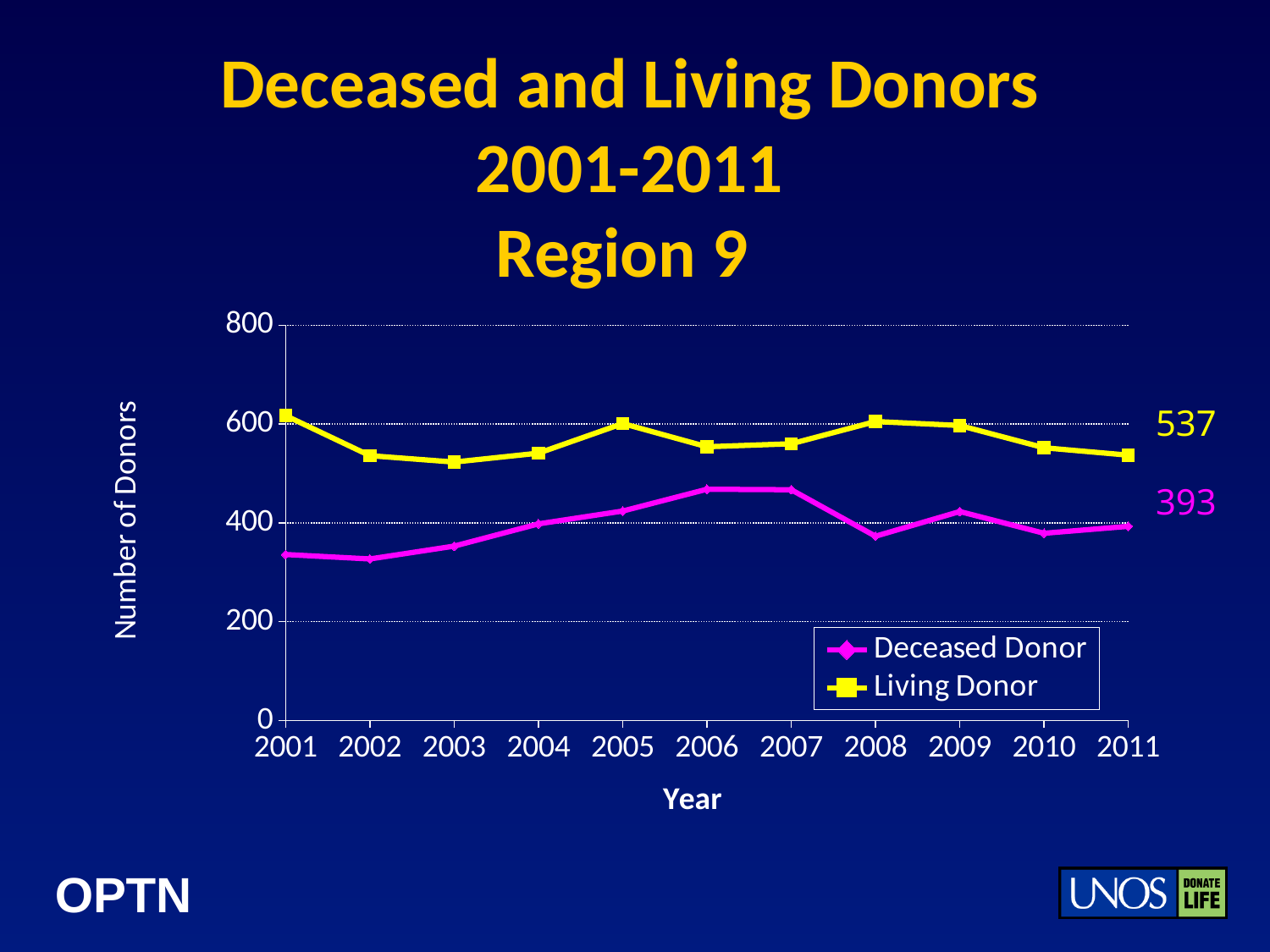
How many years are shown on the x axis? 11 Is the value for Deceased Donor in 2006 greater or less than 400? greater How many series does the legend list? 2 What kind of chart is shown on the slide? line chart What is the label on the y axis? Number of Donors What is the difference between the Living Donor and Deceased Donor values in 2011? 144 In 2011, which series has the larger value, Living Donor or Deceased Donor? Living Donor What is the value for Living Donor in 2011? 537 Is the value for Deceased Donor in 2001 greater or less than 400? less What is the value for Deceased Donor in 2011? 393 Is the value for Living Donor in 2003 greater or less than 600? less Does the Deceased Donor line rise or fall from 2001 to 2006? rise